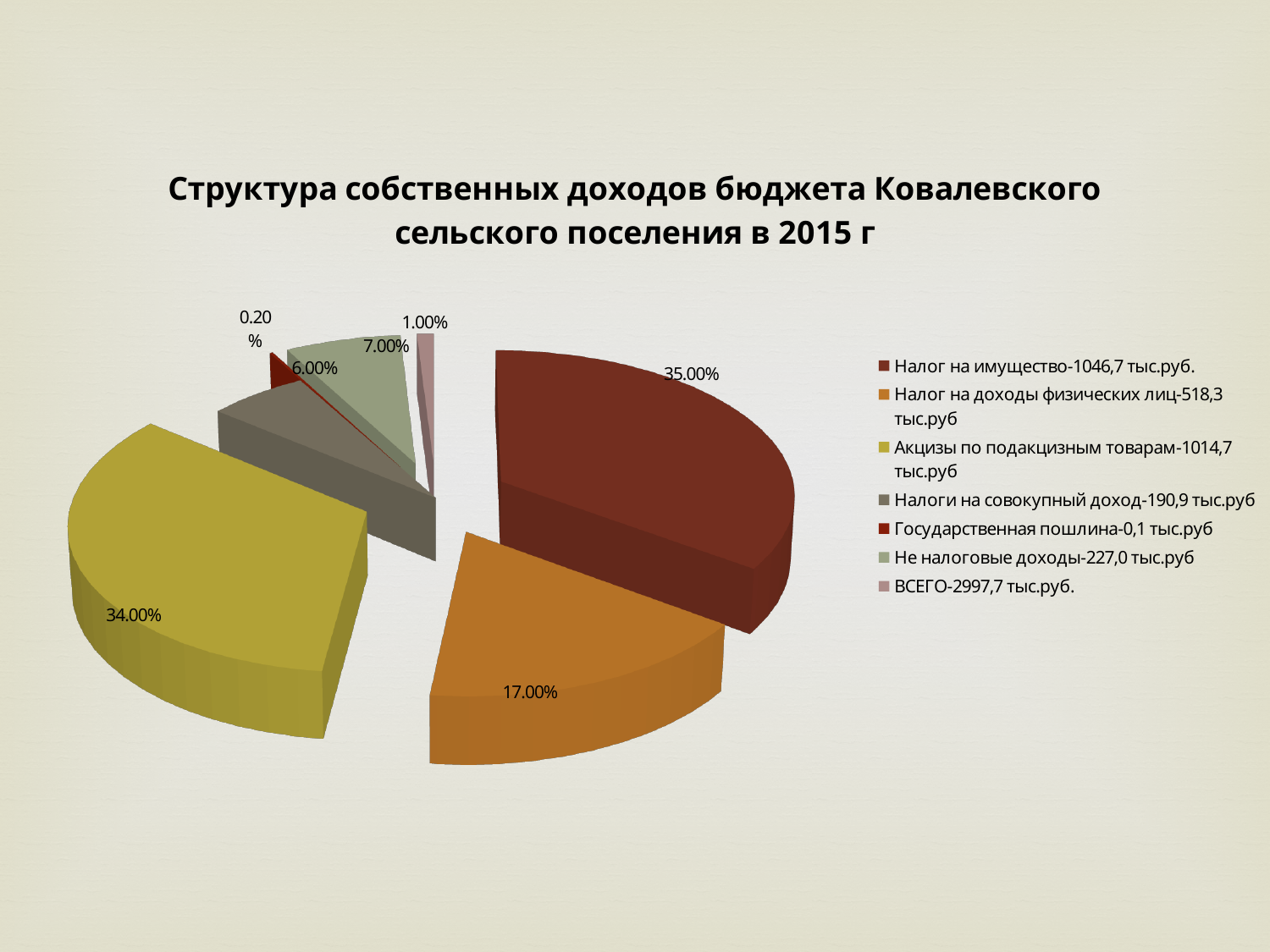
Which legend category has the smallest slice of the pie? Государственная пошлина-0,1 тыс.руб Which slice is larger: Налог на доходы физических лиц or Не налоговые доходы? Налог на доходы физических лиц What share of the pie does the slice for Налог на доходы физических лиц-518,3 тыс.руб have? 17.00% What share of the pie does the slice for Не налоговые доходы-227,0 тыс.руб have? 7.00% What kind of chart is shown on the slide? pie chart How many slices does the pie chart have? 7 What share of the pie does the slice for Налоги на совокупный доход-190,9 тыс.руб have? 6.00% What is the title of the chart? Структура собственных доходов бюджета Ковалевского сельского поселения в 2015 г What is the difference in percentage points between the slice for Налог на имущество and the slice for Акцизы по подакцизным товарам? 1.00% Which legend category has the largest slice of the pie? Налог на имущество-1046,7 тыс.руб.